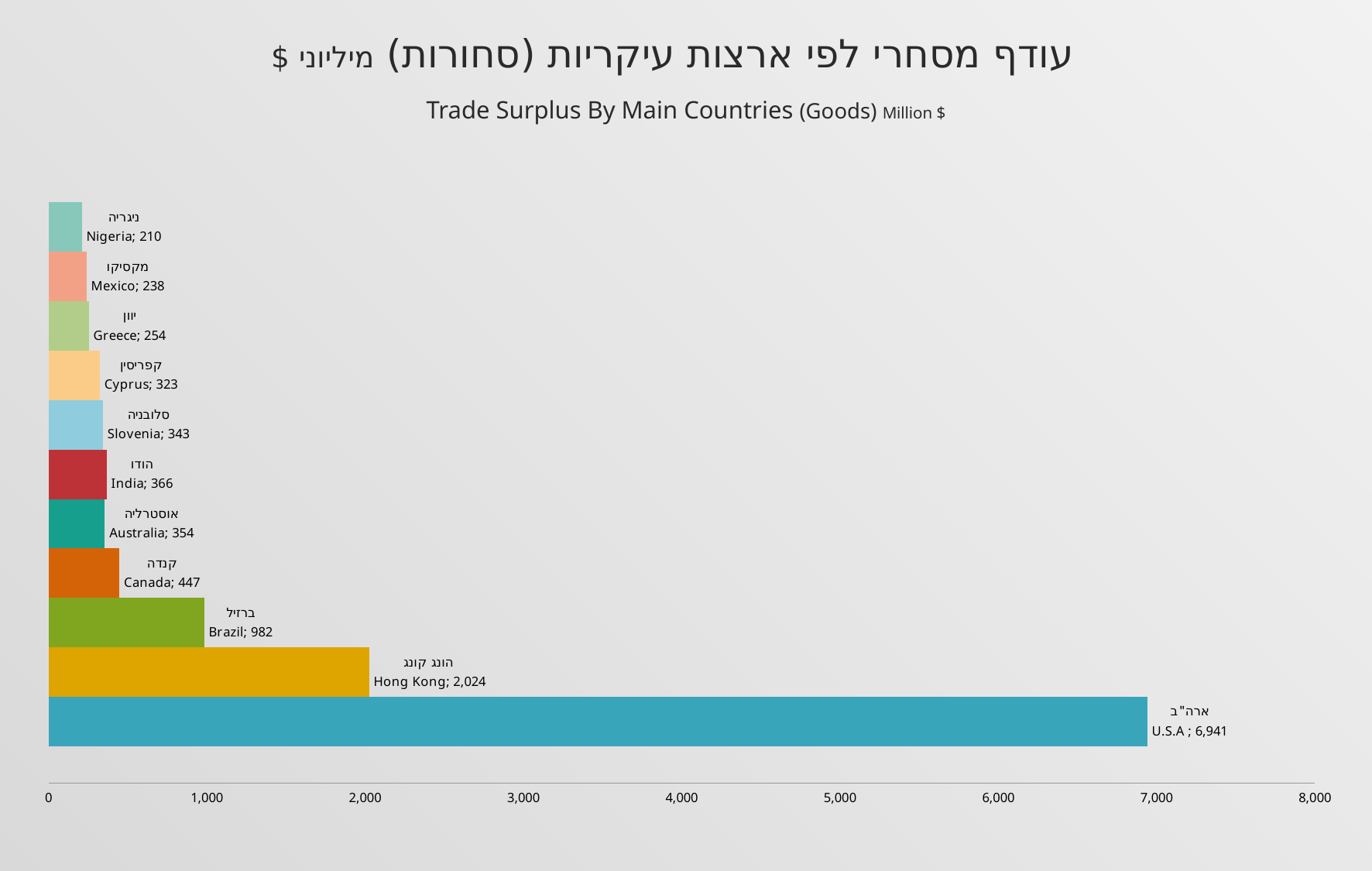
Which has a larger trade surplus, India or Australia? India What is the difference between the trade surplus of Brazil and Canada? 535 What is the trade surplus value for Slovenia? 343 What is the trade surplus value for Hong Kong? 2,024 What type of chart is shown on the slide? bar chart Which country has the lowest trade surplus? Nigeria What is the difference between the trade surplus of U.S.A and Hong Kong? 4,917 What is the trade surplus value for Canada? 447 What is the English title of the chart? Trade Surplus By Main Countries (Goods) Million $ How many countries are shown in the chart? 11 Which country has the highest trade surplus? U.S.A Is the value for Brazil greater or less than 1,000? less